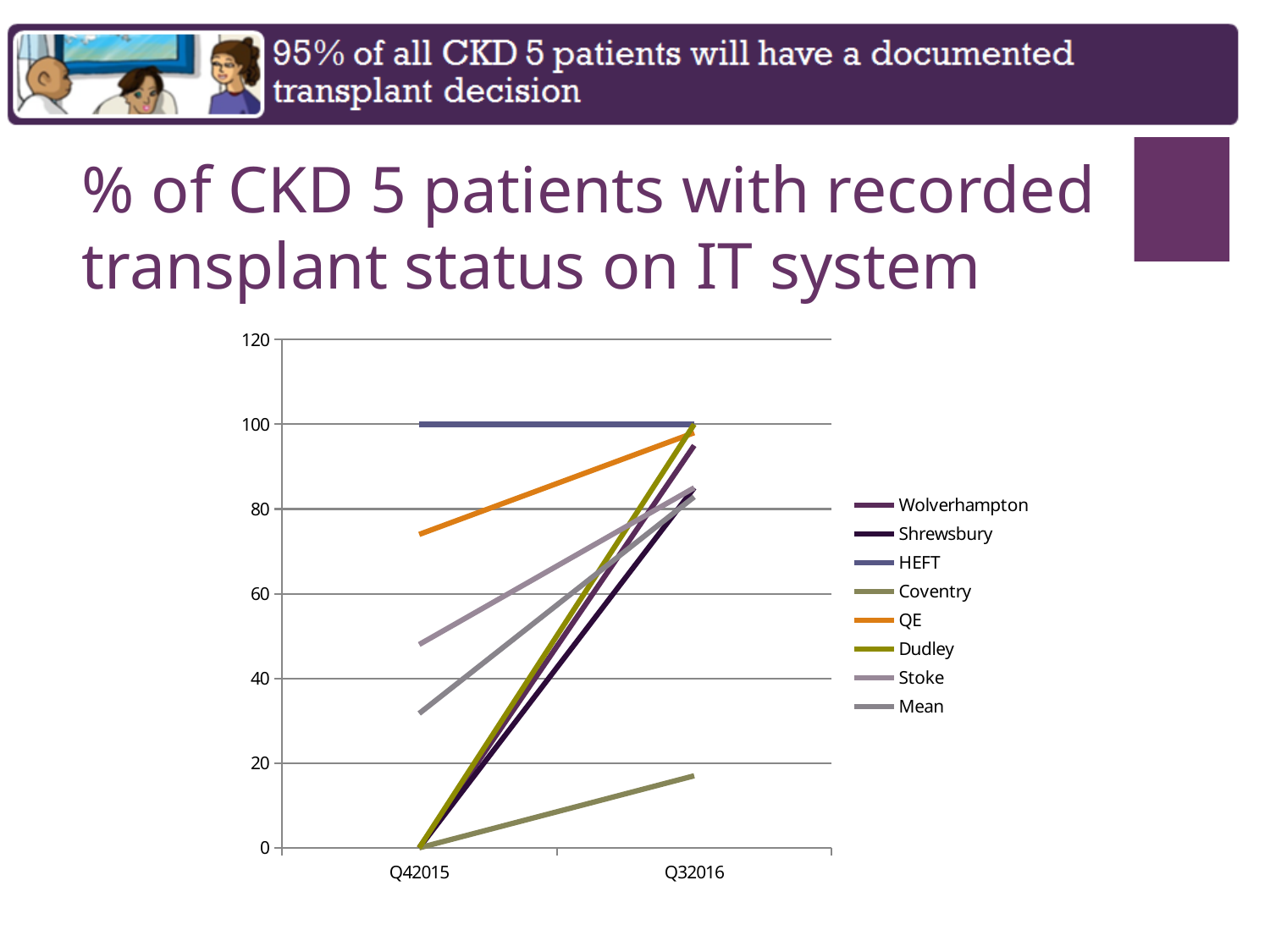
How many time points are shown on the x axis? 2 Is the value for Coventry at Q32016 greater or less than 20? less Is the value for QE at Q42015 greater or less than 60? greater What kind of chart is shown on the slide? line chart Which series has the highest value at Q42015? HEFT What is the value for Coventry at Q42015? 0 At Q42015, which is larger: the value for QE or the value for Stoke? QE Is the value for Mean at Q42015 greater or less than 40? less Does the Mean series rise or fall from Q42015 to Q32016? rise What is the value for HEFT at Q42015? 100 Which series has the lowest value at Q32016? Coventry How many series does the legend list? 8